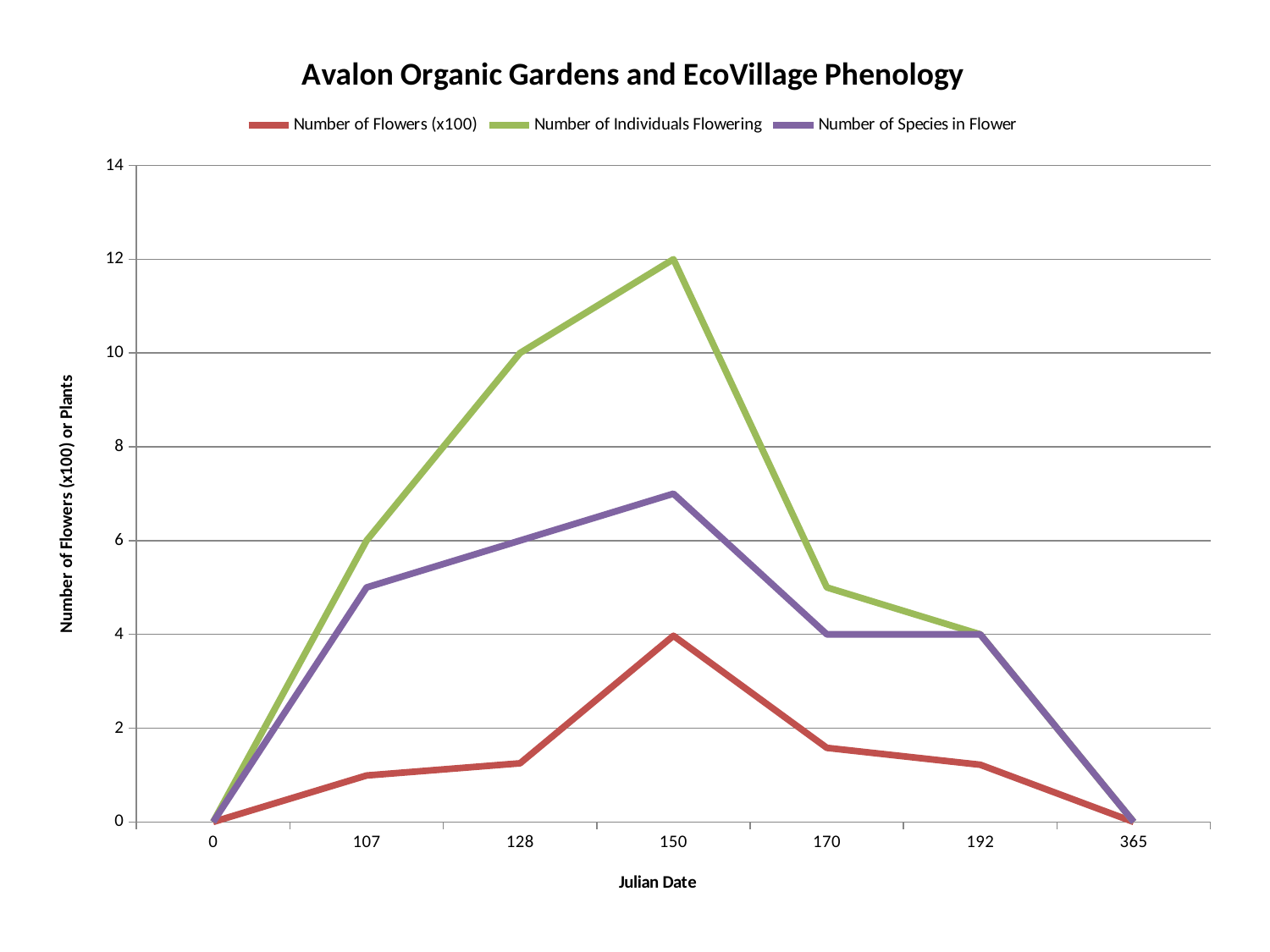
What is the value of Number of Individuals Flowering at Julian Date 150? 12 What kind of chart is shown on the slide? line chart Is the value of Number of Species in Flower at Julian Date 150 greater or less than 6? greater What is the value of Number of Individuals Flowering at Julian Date 128? 10 Which series is higher at Julian Date 128, Number of Individuals Flowering or Number of Species in Flower? Number of Individuals Flowering How many series does the legend list? 3 At which Julian Date does Number of Individuals Flowering reach its highest value? 150 What is the value of Number of Species in Flower at Julian Date 170? 4 Does Number of Individuals Flowering rise or fall between Julian Date 150 and 192? fall How many Julian Date points are plotted along the x axis? 7